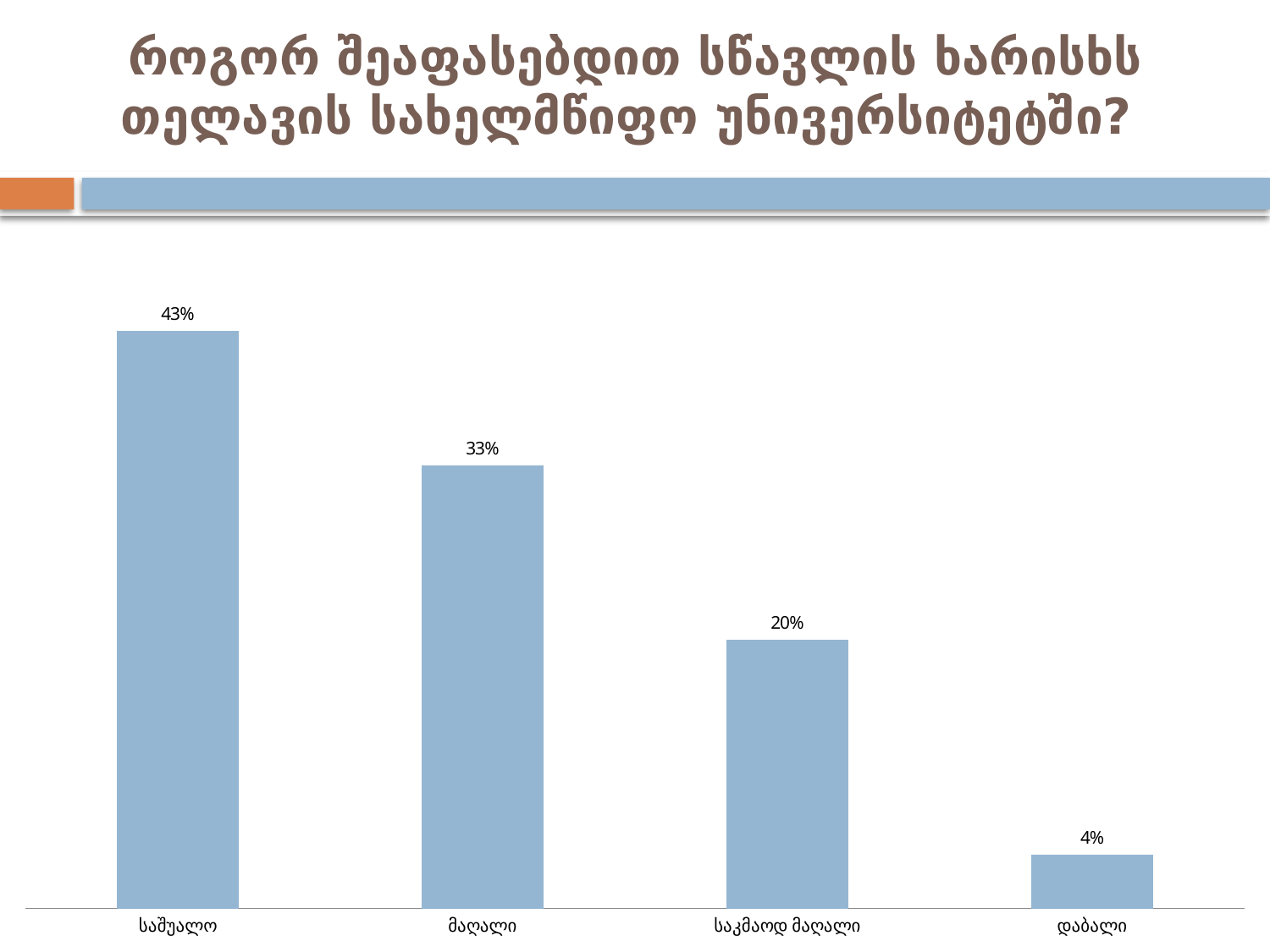
Do the values rise or fall from left to right along the x axis? fall What kind of chart is shown on the slide? bar chart What is the value for მაღალი? 33% Which category has the highest value? საშუალო What is the value for საკმაოდ მაღალი? 20% Which is larger, the value for მაღალი or the value for საკმაოდ მაღალი? მაღალი What is the value for დაბალი? 4% Which category has the lowest value? დაბალი How many categories are shown on the chart? 4 What is the difference between the values for საკმაოდ მაღალი and დაბალი? 16% What is the difference between the values for საშუალო and მაღალი? 10% What is the value for საშუალო? 43%